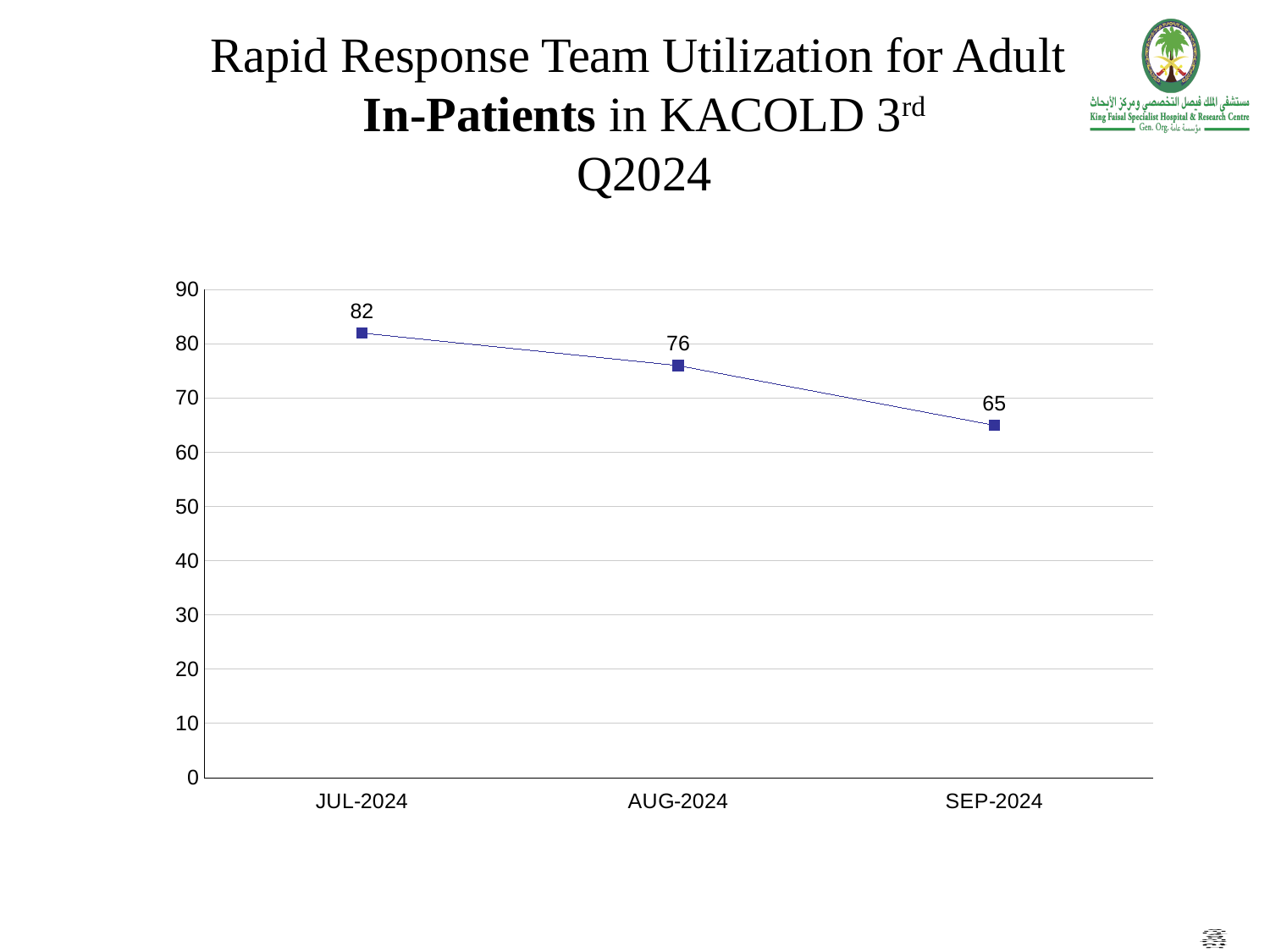
What is the difference between the values for AUG-2024 and SEP-2024? 11 What is the value for SEP-2024? 65 Do the values rise or fall from JUL-2024 to SEP-2024? fall What is the value for AUG-2024? 76 Which is larger, the value for JUL-2024 or the value for AUG-2024? JUL-2024 What is the difference between the values for JUL-2024 and SEP-2024? 17 What kind of chart is shown on the slide? line chart Which month has the highest value? JUL-2024 Is the value for SEP-2024 greater or less than 70? less Which month has the lowest value? SEP-2024 What is the value for JUL-2024? 82 How many months are plotted on the chart? 3